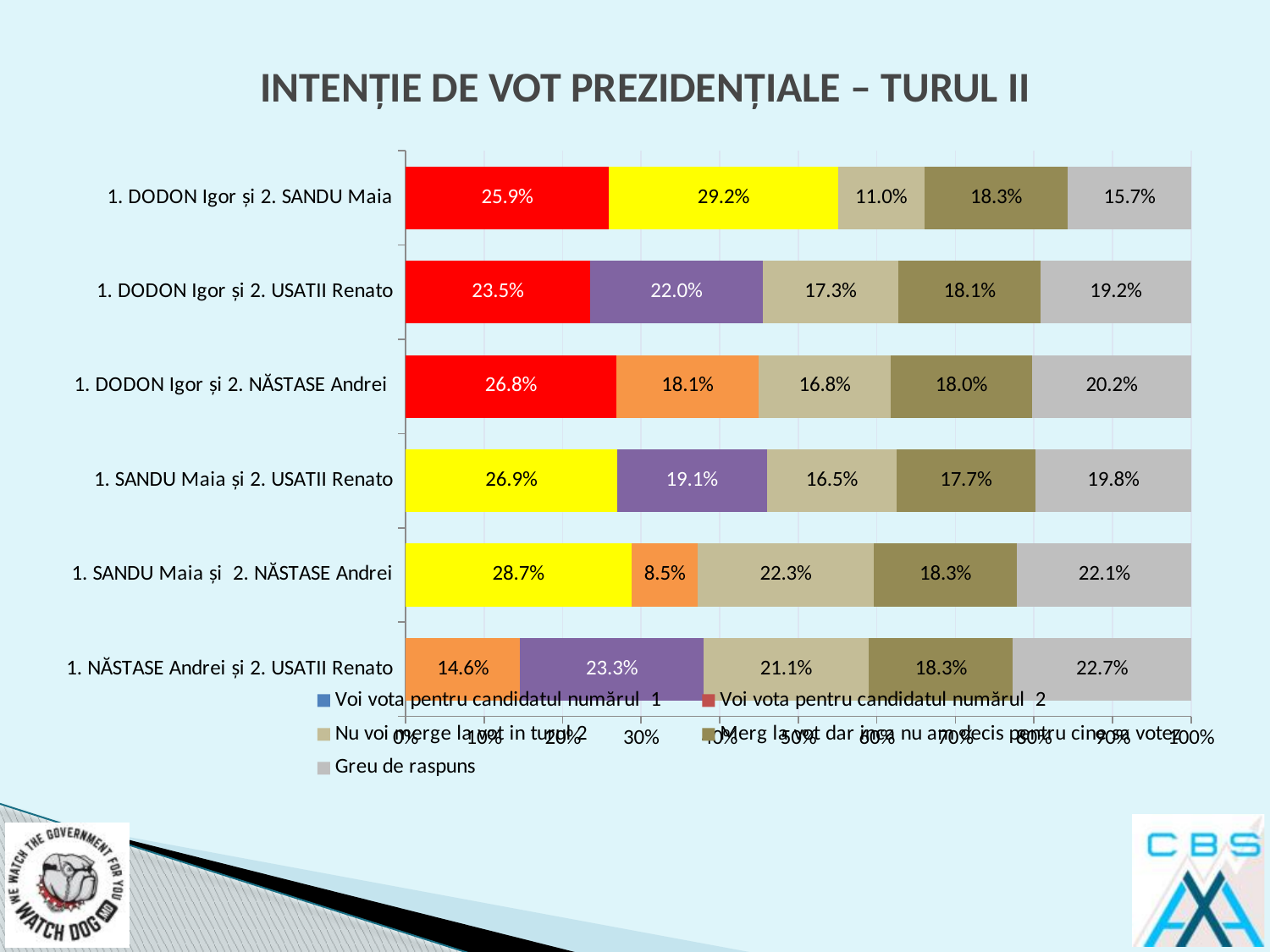
What is the title of the chart on the slide? INTENȚIE DE VOT PREZIDENȚIALE – TURUL II Which pairing has the highest 'Greu de raspuns' value? 1. NĂSTASE Andrei și 2. USATII Renato What kind of chart is shown on the slide? Stacked bar chart Which pairing has the lowest 'Nu voi merge la vot in turul 2' value? 1. DODON Igor și 2. SANDU Maia In the pairing '1. DODON Igor și 2. SANDU Maia', what is the difference between the second segment (29.2%) and the first segment (25.9%)? 3.3 percentage points How many candidate pairings (categories) are shown in the chart? 6 What is the 'Nu voi merge la vot in turul 2' value for the pairing '1. NĂSTASE Andrei și 2. USATII Renato'? 21.1% What is the value of the first segment (vote for candidate number 1) for the pairing '1. SANDU Maia și 2. NĂSTASE Andrei'? 28.7% In the pairing '1. DODON Igor și 2. USATII Renato', which is larger: the first segment or the second segment? The first segment (23.5%) What is the 'Merg la vot dar inca nu am decis pentru cine sa votez' value for the pairing '1. SANDU Maia și 2. USATII Renato'? 17.7% What is the 'Greu de raspuns' value for the pairing '1. DODON Igor și 2. SANDU Maia'? 15.7% How many series does the chart legend list? 5